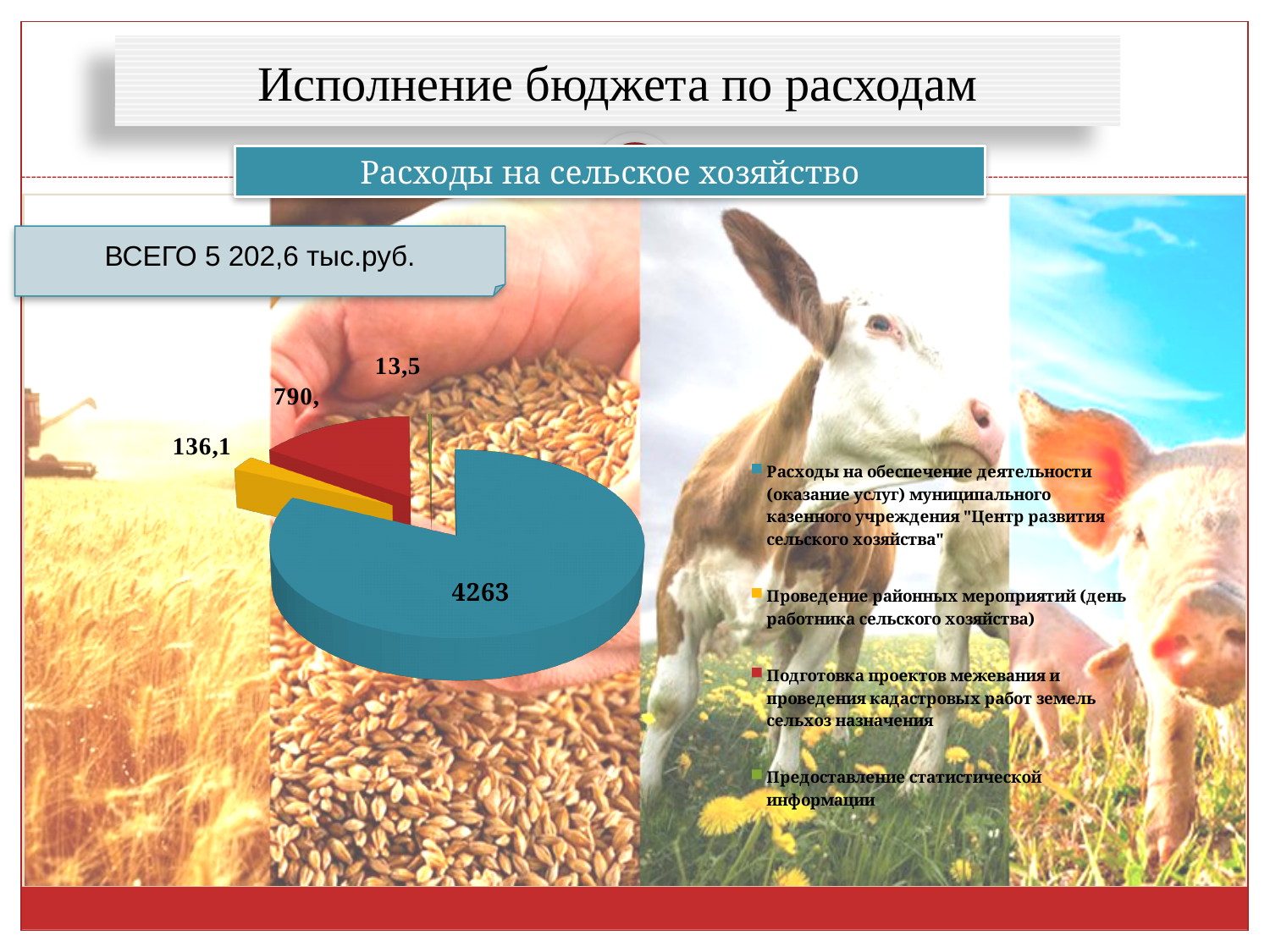
How many slices does the pie chart have? 4 What is the difference between the value for 'Расходы на обеспечение деятельности (оказание услуг) муниципального казенного учреждения "Центр развития сельского хозяйства"' and the value for 'Проведение районных мероприятий (день работника сельского хозяйства)'? 4126,9 What is the value for 'Проведение районных мероприятий (день работника сельского хозяйства)'? 136,1 What is the value for 'Предоставление статистической информации'? 13,5 What kind of chart is shown on the slide? pie chart What is the value for 'Расходы на обеспечение деятельности (оказание услуг) муниципального казенного учреждения "Центр развития сельского хозяйства"'? 4263 What colour is the slice for 'Подготовка проектов межевания и проведения кадастровых работ земель сельхоз назначения'? red What is the title of the chart? Расходы на сельское хозяйство How many entries does the legend list? 4 Which is larger: the value for 'Проведение районных мероприятий (день работника сельского хозяйства)' or the value for 'Подготовка проектов межевания и проведения кадастровых работ земель сельхоз назначения'? Подготовка проектов межевания и проведения кадастровых работ земель сельхоз назначения Which category has the smallest slice of the pie? Предоставление статистической информации Which category has the largest slice of the pie? Расходы на обеспечение деятельности (оказание услуг) муниципального казенного учреждения "Центр развития сельского хозяйства"